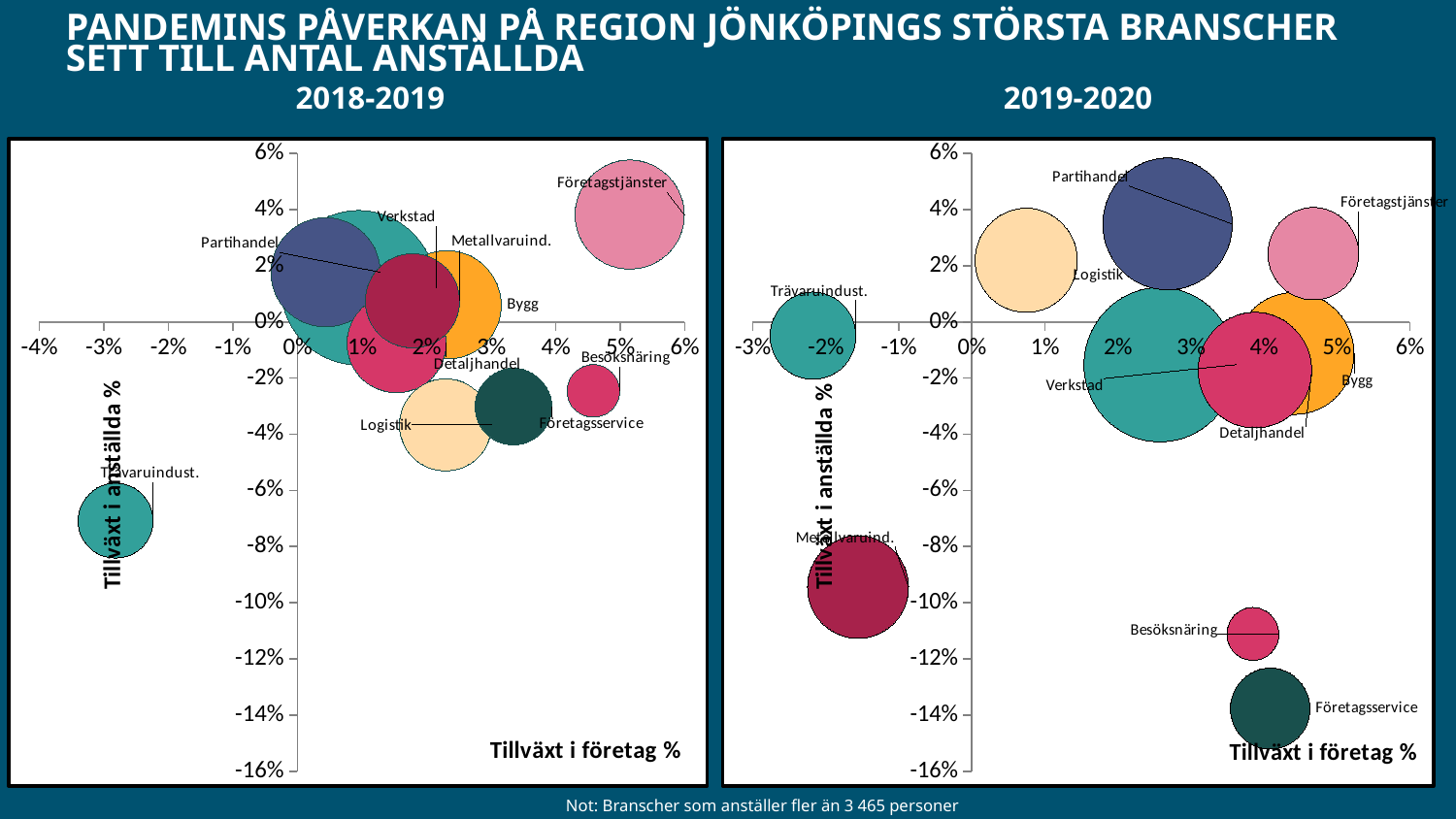
In the 2019-2020 chart, which industry has the highest employee growth (Tillväxt i anställda %)? Partihandel In the 2019-2020 chart, is the employee growth (Tillväxt i anställda %) for Företagsservice greater or less than -12%? less In the 2019-2020 chart, which has the higher employee growth (Tillväxt i anställda %): Besöksnäring or Metallvaruind.? Metallvaruind. What kind of chart is the 2018-2019 chart? bubble chart In the 2018-2019 chart, which industry has the lowest employee growth (Tillväxt i anställda %)? Trävaruindust. In the 2018-2019 chart, is the company growth (Tillväxt i företag %) for Företagstjänster greater or less than 4%? greater In the 2018-2019 chart, which industry has the highest employee growth (Tillväxt i anställda %)? Företagstjänster What is the label of the horizontal axis in the 2019-2020 chart? Tillväxt i företag % In the 2019-2020 chart, which industry has the lowest employee growth (Tillväxt i anställda %)? Företagsservice How many industries are plotted as bubbles in the 2018-2019 chart? 10 In the 2018-2019 chart, is the employee growth (Tillväxt i anställda %) for Trävaruindust. greater or less than -6%? less